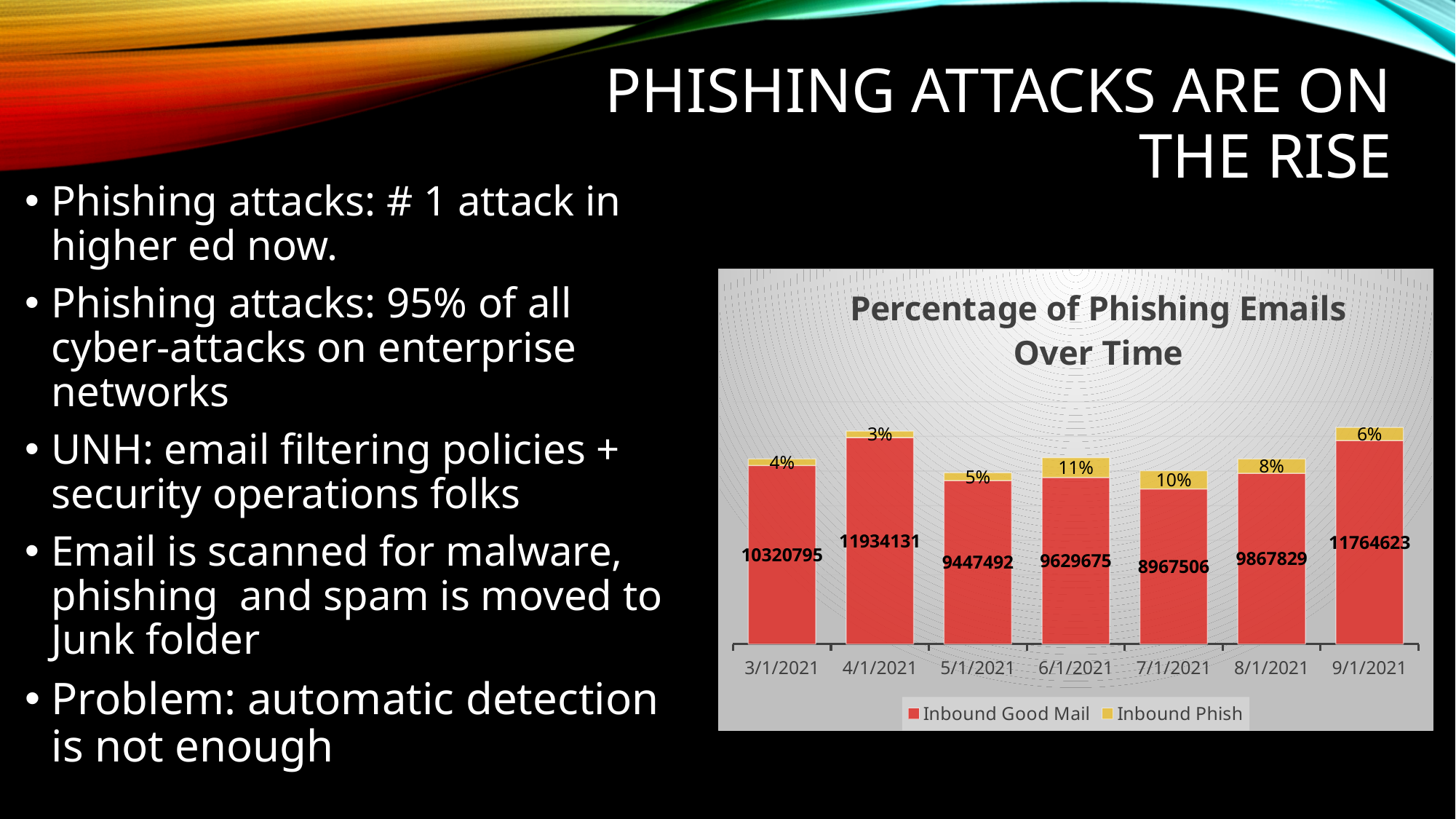
What is the title of the chart? Percentage of Phishing Emails Over Time Does the Inbound Phish percentage rise or fall from 6/1/2021 to 9/1/2021? Fall What is the Inbound Good Mail value for 7/1/2021? 8967506 What is the difference between the Inbound Good Mail values for 4/1/2021 and 3/1/2021? 1613336 How many dates are shown on the x axis of the chart? 7 What is the Inbound Phish percentage labelled for 6/1/2021? 11% What is the Inbound Good Mail value for 4/1/2021? 11934131 Which date has the lowest Inbound Good Mail value? 7/1/2021 How many series does the chart legend list? 2 Which date has the highest Inbound Phish percentage? 6/1/2021 What type of chart is shown on the slide? Stacked bar chart Which has the larger Inbound Good Mail value, 3/1/2021 or 9/1/2021? 9/1/2021